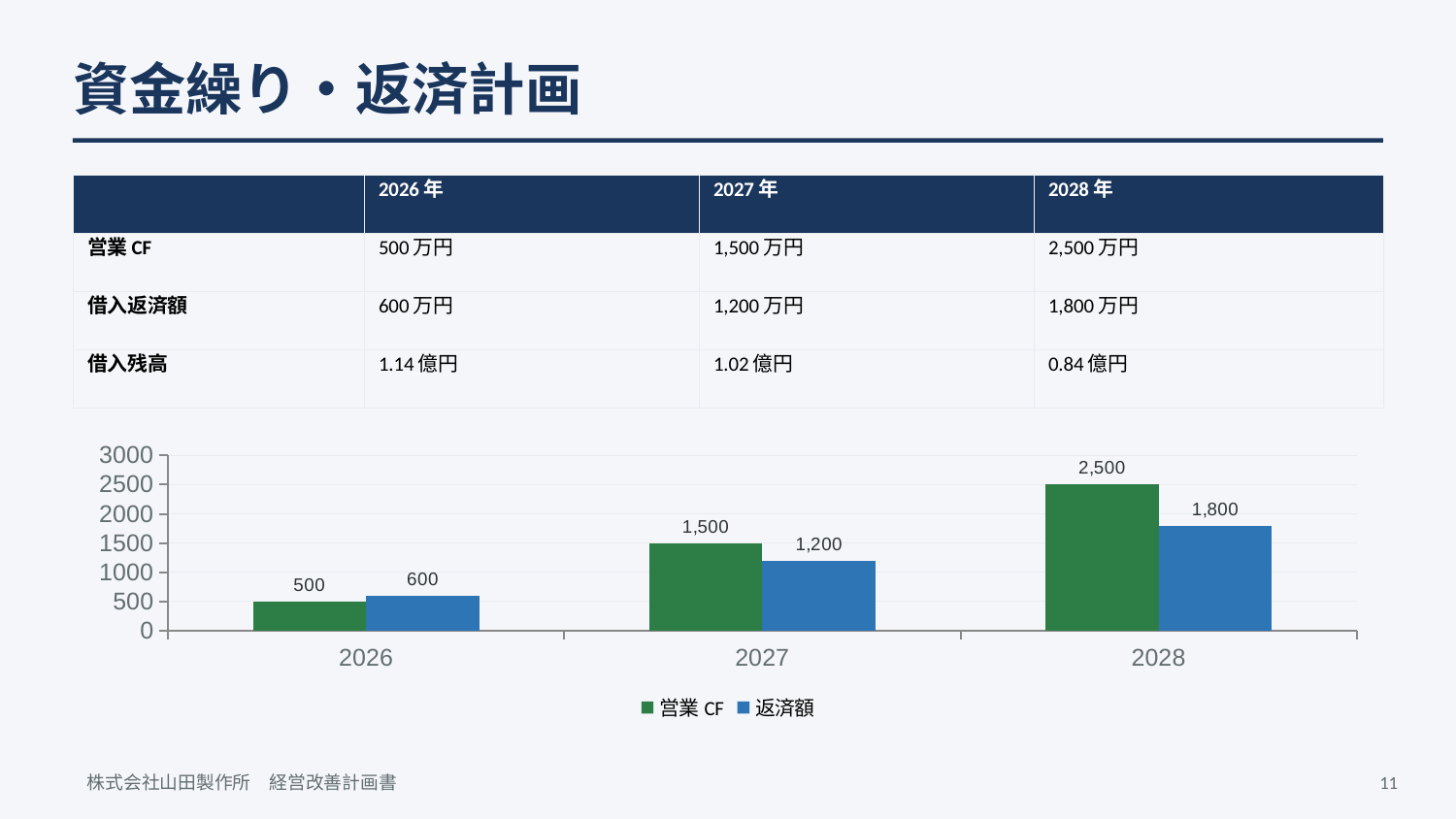
What type of chart is shown on the slide? Bar chart Which year has the lowest 返済額 value in the chart? 2026 In 2027, which is larger: 営業 CF or 返済額? 営業 CF How many series does the chart legend list? 2 Which year has the highest 営業 CF value in the chart? 2028 What is the difference between 営業 CF and 返済額 in 2028? 700 How many years are shown on the x axis of the chart? 3 What is the value of 営業 CF for 2027 in the chart? 1,500 In 2026, which is larger: 営業 CF or 返済額? 返済額 Does the 営業 CF value rise or fall from 2026 to 2028? Rise What is the value of 返済額 for 2026 in the chart? 600 What is the value of 返済額 for 2028 in the chart? 1,800